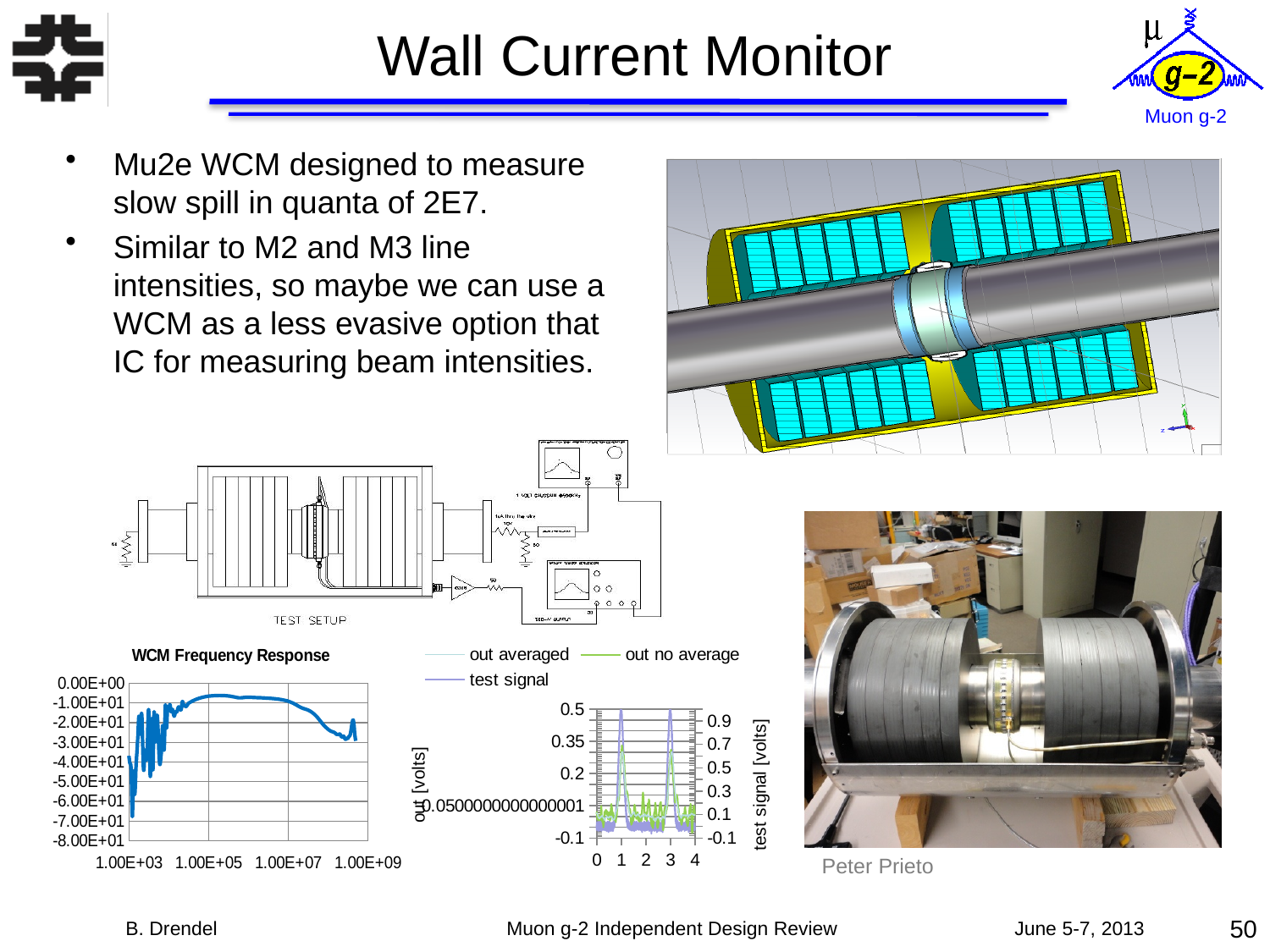
What is the title of the chart at the bottom left of the slide? WCM Frequency Response What kind of chart is the chart with the 'out [volts]' and 'test signal [volts]' axes? line chart How many series does the legend list for the chart with the 'out [volts]' axis? 3 In the chart with the 'out [volts]' axis, what is the highest value shown on the right-hand 'test signal [volts]' axis? 0.9 What kind of chart is the 'WCM Frequency Response' chart? line chart In the 'WCM Frequency Response' chart, does the curve rise or fall between 1.00E+07 and 1.00E+09 on the x axis? fall In the 'WCM Frequency Response' chart, what is the lowest value shown on the y axis? -8.00E+01 In the 'WCM Frequency Response' chart, does the curve rise or fall between 1.00E+03 and 1.00E+05 on the x axis? rise In the 'WCM Frequency Response' chart, is the peak value of the curve greater or less than -2.00E+01? greater